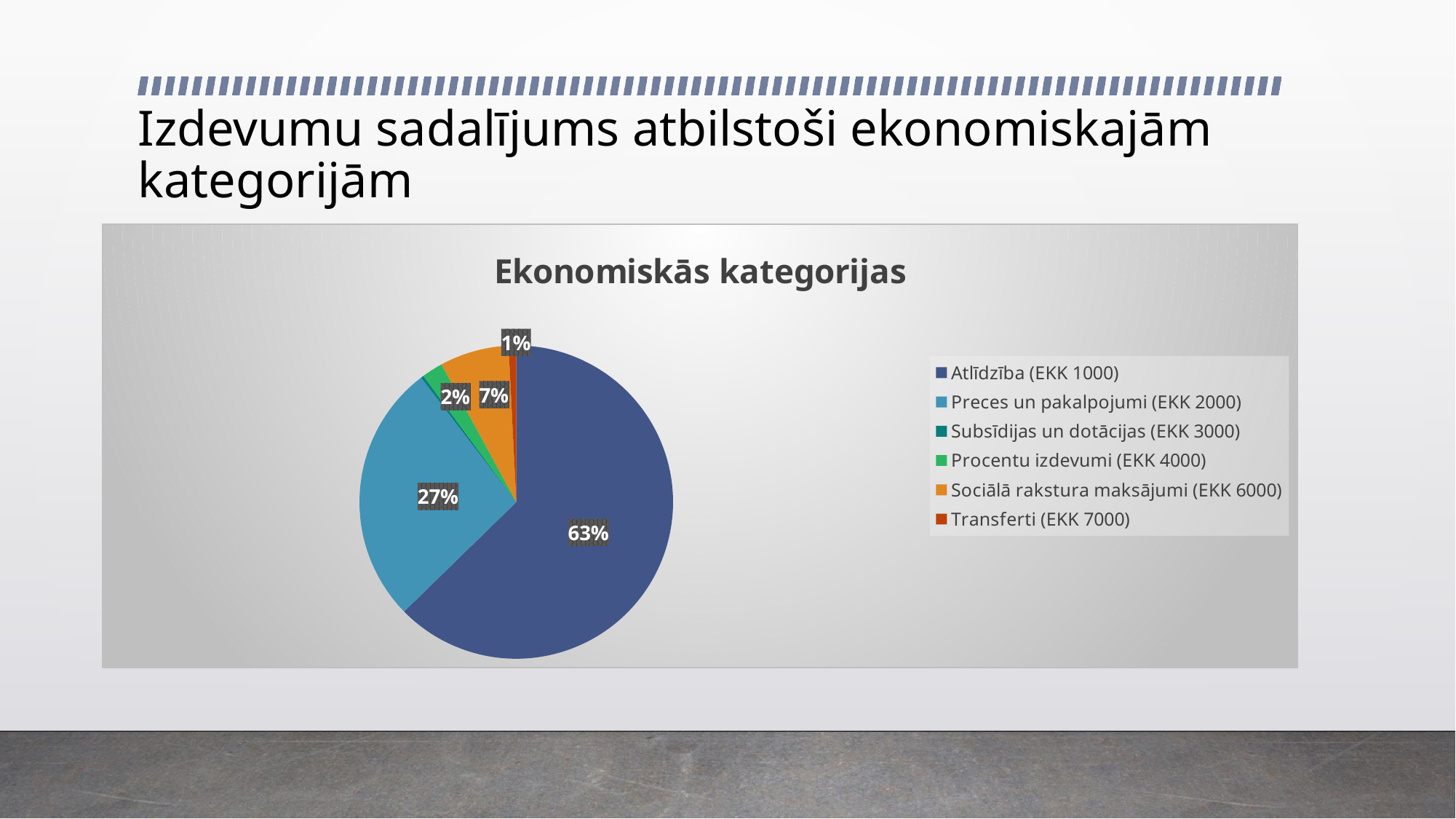
What is the difference between the shares of Atlīdzība (EKK 1000) and Preces un pakalpojumi (EKK 2000)? 36% What kind of chart is shown on the slide? pie chart What colour is the slice for Preces un pakalpojumi (EKK 2000)? light blue What share of the pie does Preces un pakalpojumi (EKK 2000) take? 27% What share of the pie does Atlīdzība (EKK 1000) take? 63% What is the value shown for Transferti (EKK 7000)? 1% What is the value shown for Procentu izdevumi (EKK 4000)? 2% Which category has the largest slice of the pie? Atlīdzība (EKK 1000) How many categories does the legend list? 6 What is the value shown for Sociālā rakstura maksājumi (EKK 6000)? 7% What is the title of the chart? Ekonomiskās kategorijas Which is larger, the share for Sociālā rakstura maksājumi (EKK 6000) or the share for Procentu izdevumi (EKK 4000)? Sociālā rakstura maksājumi (EKK 6000)